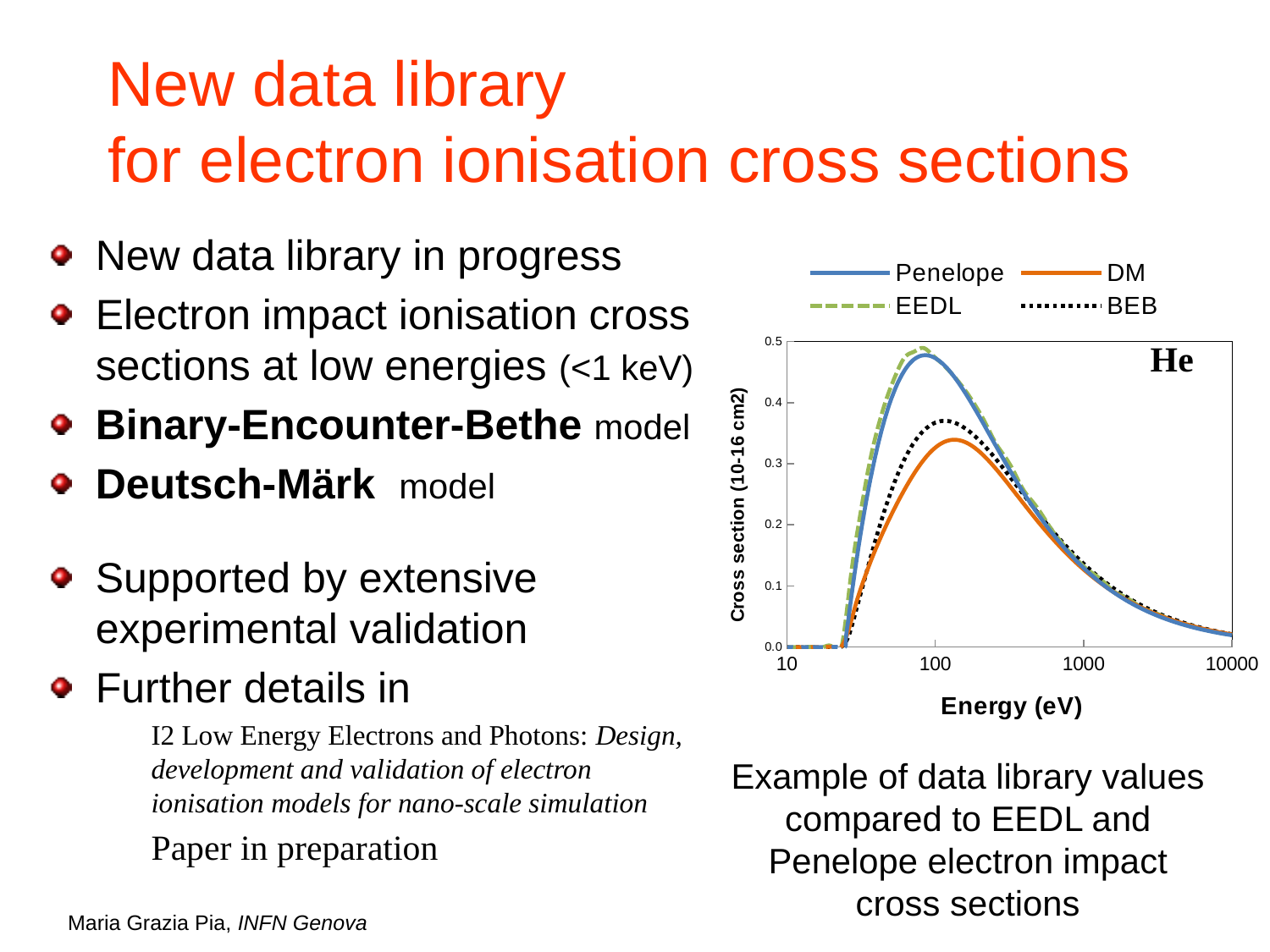
Which series reaches the lowest peak cross section? DM Is the peak value of the DM series greater or less than 0.3? greater What kind of chart is shown on the slide? line chart Is the peak value of the Penelope series greater or less than 0.4? greater Which series are listed in the chart legend? Penelope, DM, EEDL, BEB What is the title of the x axis of the chart? Energy (eV) What is the highest energy value shown on the x axis? 10000 Which has the higher peak cross section, Penelope or DM? Penelope Do the cross section values rise or fall as energy increases from 100 eV to 10000 eV? fall Which has the higher peak cross section, BEB or DM? BEB How many series does the chart legend list? 4 Is the peak value of the BEB series greater or less than 0.4? less